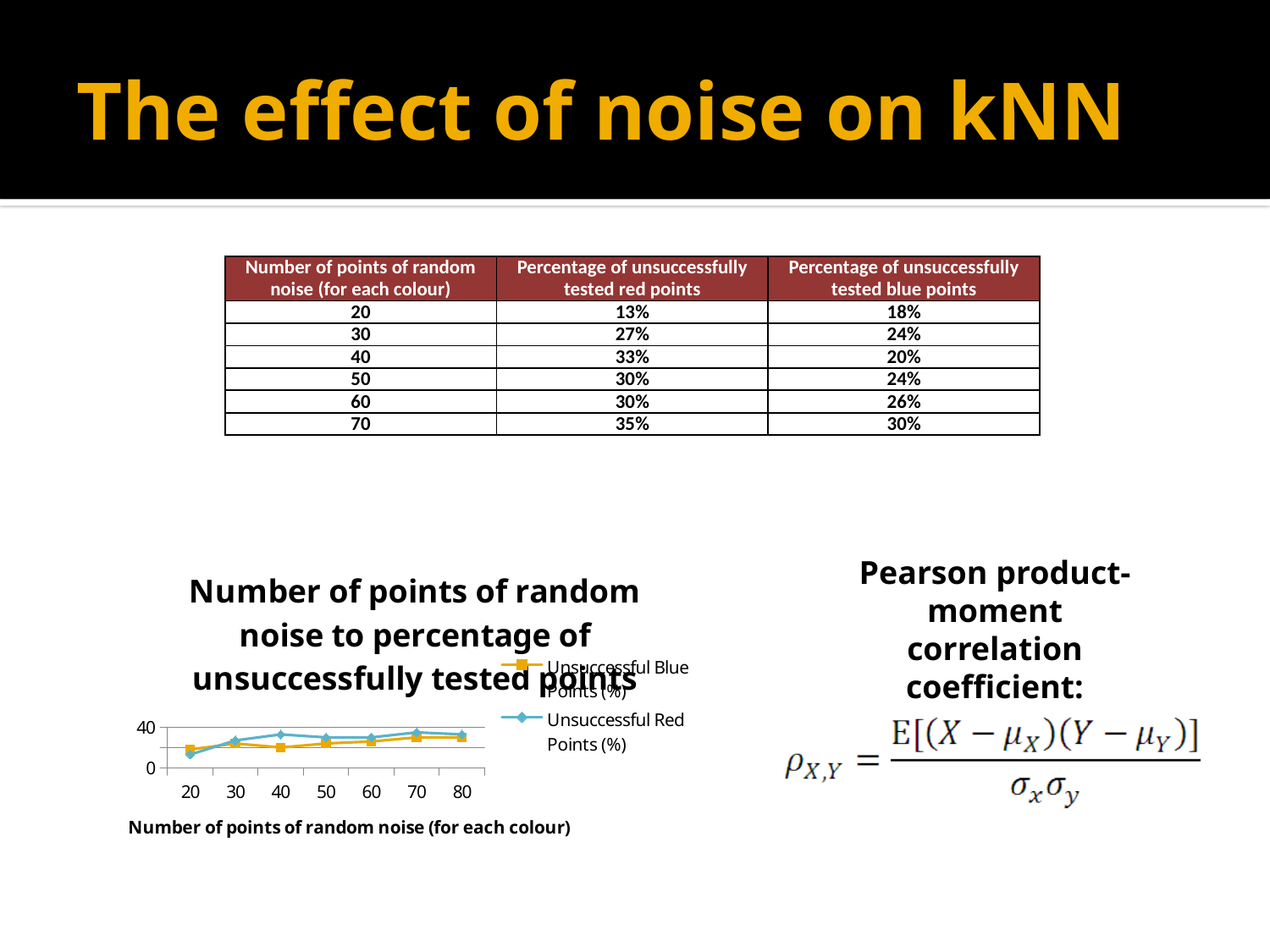
Is the value for Unsuccessful Red Points (%) at 40 greater or less than 40? less At 40 points of random noise, which series has the larger value, Unsuccessful Red Points (%) or Unsuccessful Blue Points (%)? Unsuccessful Red Points (%) Is the value for Unsuccessful Blue Points (%) at 20 greater or less than 40? less What kind of chart is shown on the slide? line chart Do the values of the Unsuccessful Red Points (%) series generally rise or fall as the number of points of random noise increases? rise At which number of points of random noise is the Unsuccessful Red Points (%) series lowest? 20 How many series does the chart's legend list? 2 How many x-axis tick values are shown on the chart? 7 What is the x-axis label of the chart? Number of points of random noise (for each colour) What are the two series named in the chart's legend? Unsuccessful Blue Points (%) and Unsuccessful Red Points (%) Do the values of the Unsuccessful Blue Points (%) series generally rise or fall from 20 to 80 points of random noise? rise